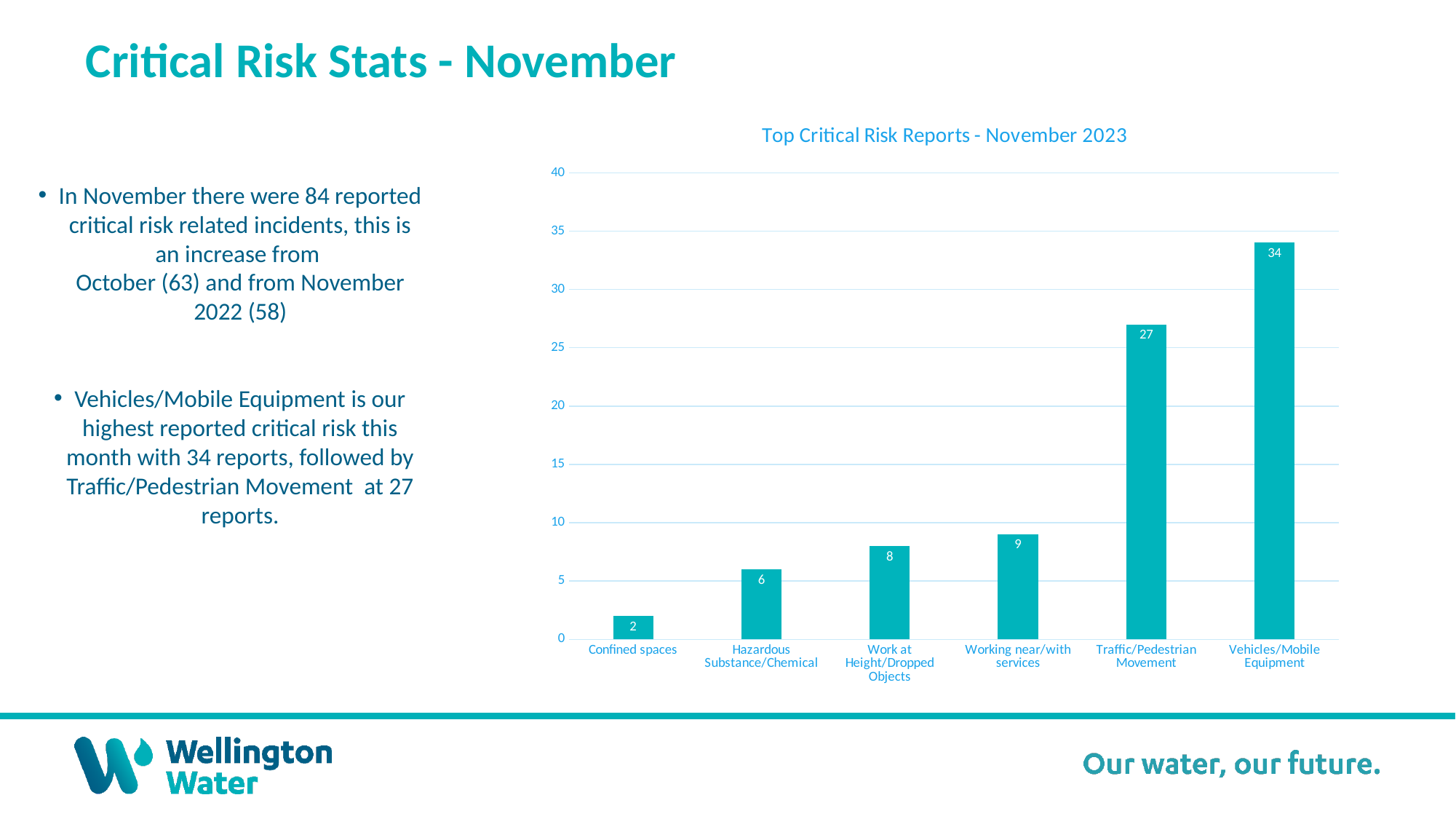
How many categories are shown on the chart? 6 Which category has the highest value? Vehicles/Mobile Equipment What is the value for Traffic/Pedestrian Movement? 27 What is the title of the chart? Top Critical Risk Reports - November 2023 Which is larger, Hazardous Substance/Chemical or Work at Height/Dropped Objects? Work at Height/Dropped Objects What is the difference between Vehicles/Mobile Equipment and Traffic/Pedestrian Movement? 7 Is the value for Traffic/Pedestrian Movement greater or less than 25? greater Which category has the lowest value? Confined spaces What is the value for Working near/with services? 9 What is the value for Confined spaces? 2 What is the value for Vehicles/Mobile Equipment? 34 What kind of chart is shown? bar chart